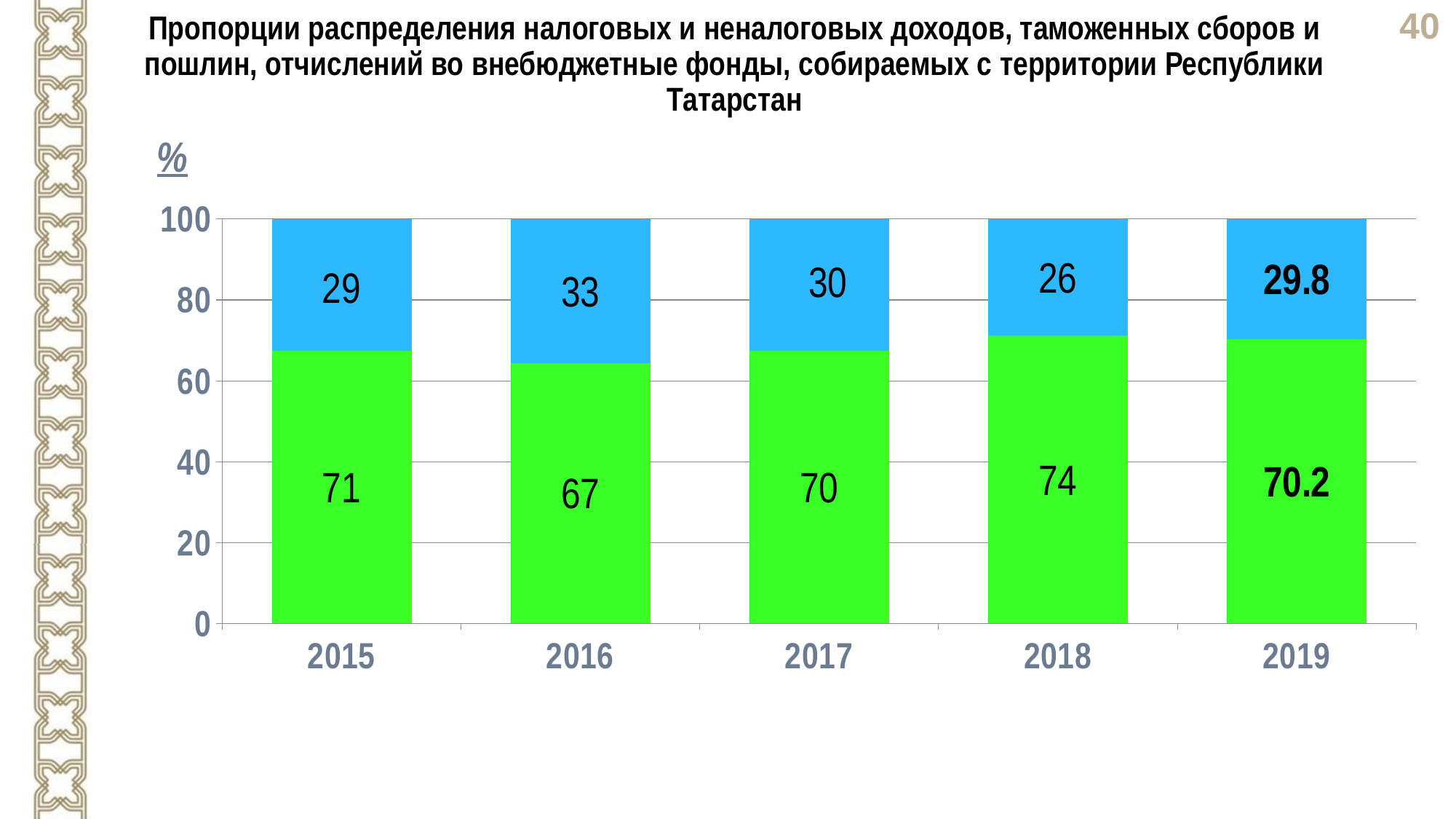
What kind of chart is shown on the slide? Stacked bar chart In which year is the green segment the largest? 2018 What is the difference between the green segment values for 2018 and 2016? 7 How many years are shown on the x axis? 5 In which year is the blue segment the largest? 2016 What is the total of the stacked bar for 2017? 100 What is the value of the blue segment for 2016? 33 Which is larger, the blue segment for 2015 or the blue segment for 2018? 2015 What is the value of the green segment for 2018? 74 What is the value of the green segment for 2019? 70.2 What is the value of the blue segment for 2019? 29.8 In which year is the green segment the smallest? 2016